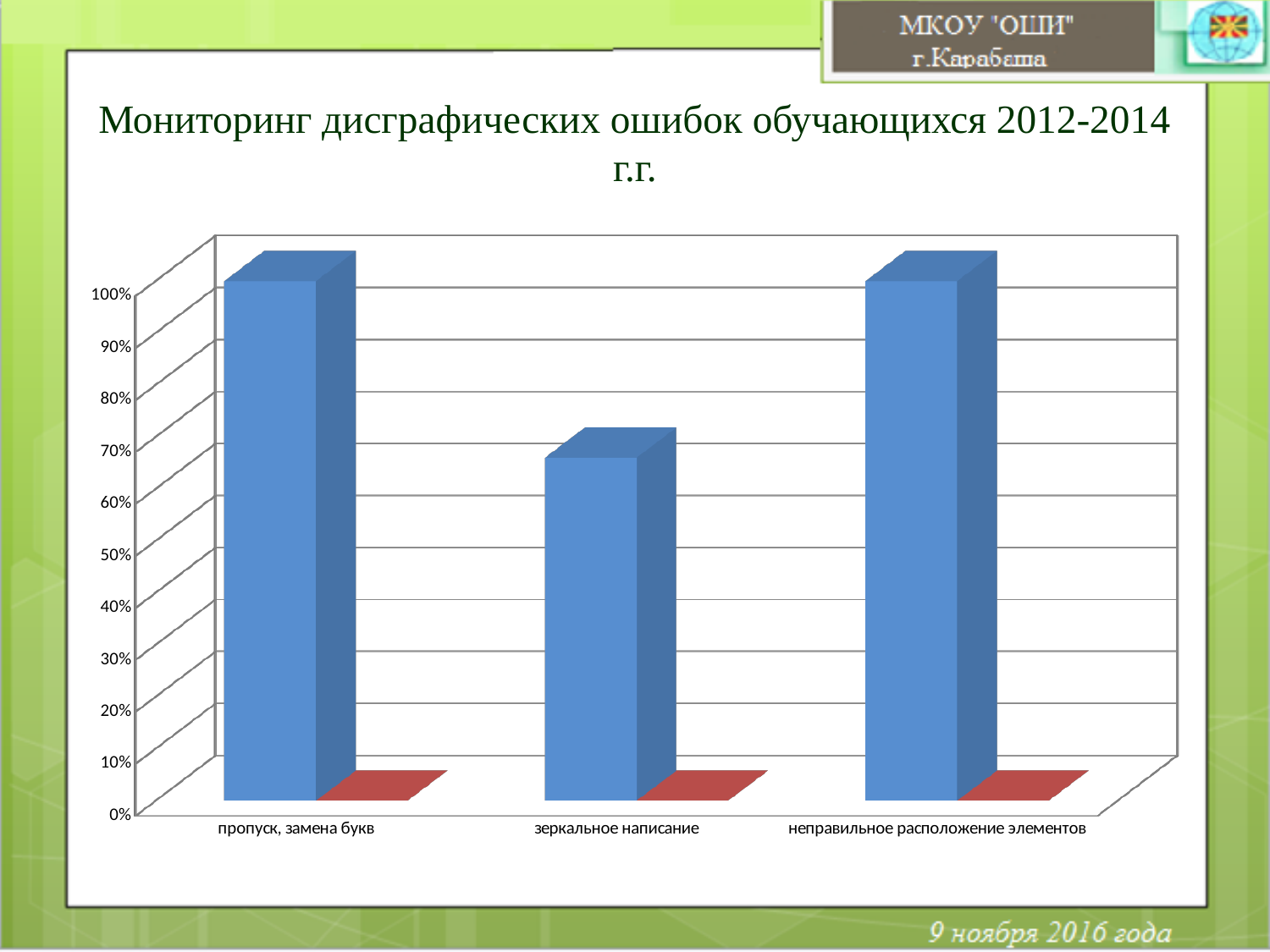
How many categories are shown on the x axis of the chart? 3 Which category has the lowest blue bar? зеркальное написание Do the blue bars rise or fall from "пропуск, замена букв" to "зеркальное написание"? fall What colour are the tall bars in the chart? blue Is the blue bar for "зеркальное написание" greater or less than 80%? less Is the blue bar for "пропуск, замена букв" greater or less than 90%? greater Which has the larger blue bar: "зеркальное написание" or "неправильное расположение элементов"? неправильное расположение элементов What is the title of the chart on the slide? Мониторинг дисграфических ошибок обучающихся 2012-2014 г.г. Is the blue bar for "неправильное расположение элементов" greater or less than 90%? greater What kind of chart is shown on the slide? bar chart Which has the larger blue bar: "пропуск, замена букв" or "зеркальное написание"? пропуск, замена букв